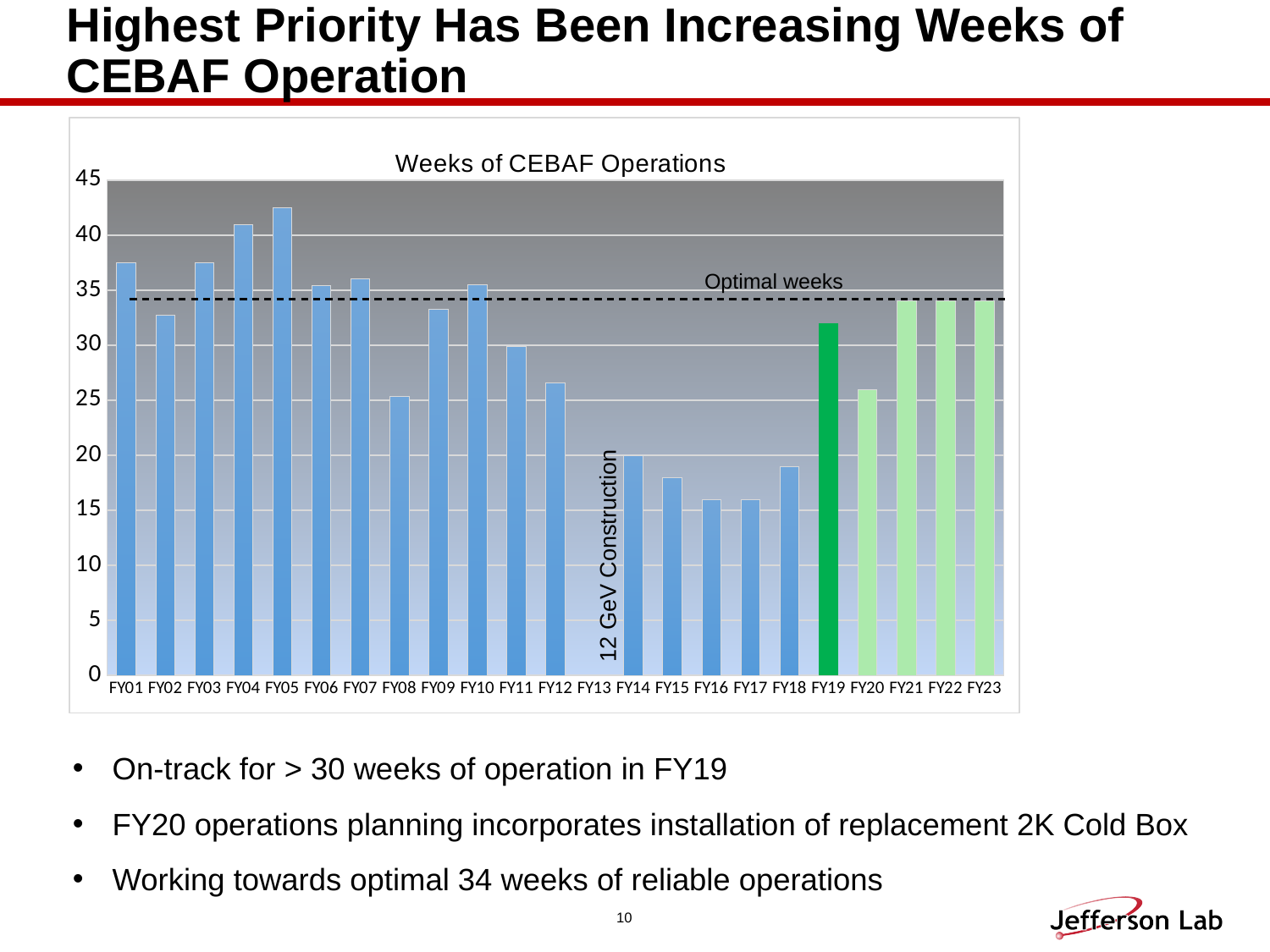
Which fiscal year has the highest number of weeks of CEBAF operations? FY05 Do the values rise or fall from FY10 to FY12? fall How many fiscal-year categories are labelled on the x axis? 23 What is the title of the chart? Weeks of CEBAF Operations What kind of chart is shown on the slide? bar chart Which has more weeks of operation, FY14 or FY15? FY14 Is the value for FY15 greater or less than 20? less Which has more weeks of operation, FY19 or FY20? FY19 Is the value for FY19 greater or less than 30? greater Is the value for FY05 greater or less than 40? greater What label is written in place of a bar for FY13? 12 GeV Construction